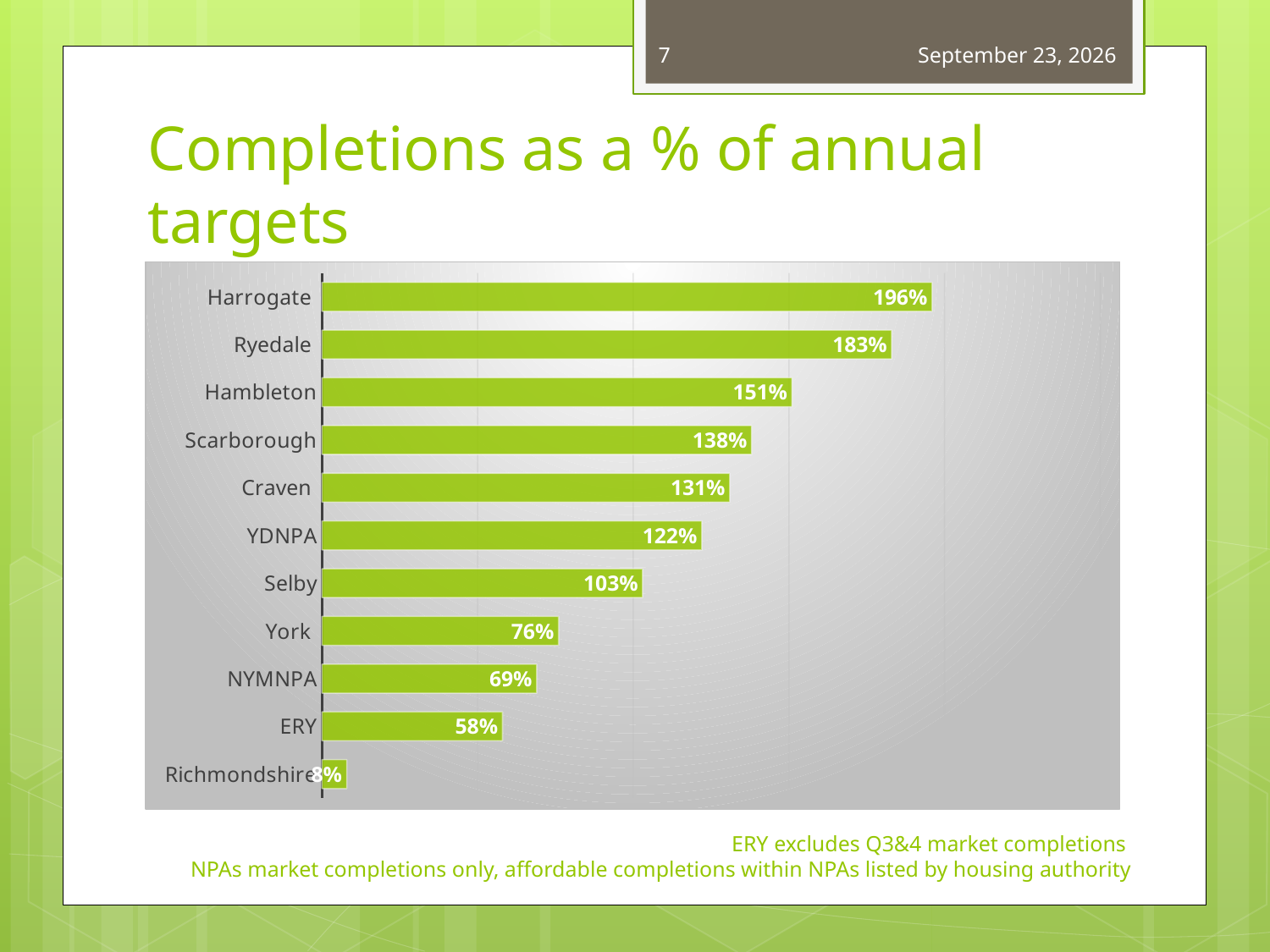
What is the value for Harrogate? 196% Which is larger, the value for Craven or the value for YDNPA? Craven Which category has the lowest value? Richmondshire What is the value for Richmondshire? 8% Which category has the highest value? Harrogate What is the value for NYMNPA? 69% How many categories are shown in the chart? 11 What is the title of the slide containing the chart? Completions as a % of annual targets What is the difference between the values for Selby and York? 27% What kind of chart is shown on the slide? Bar chart What is the difference between the values for Harrogate and Ryedale? 13% What is the value for Scarborough? 138%